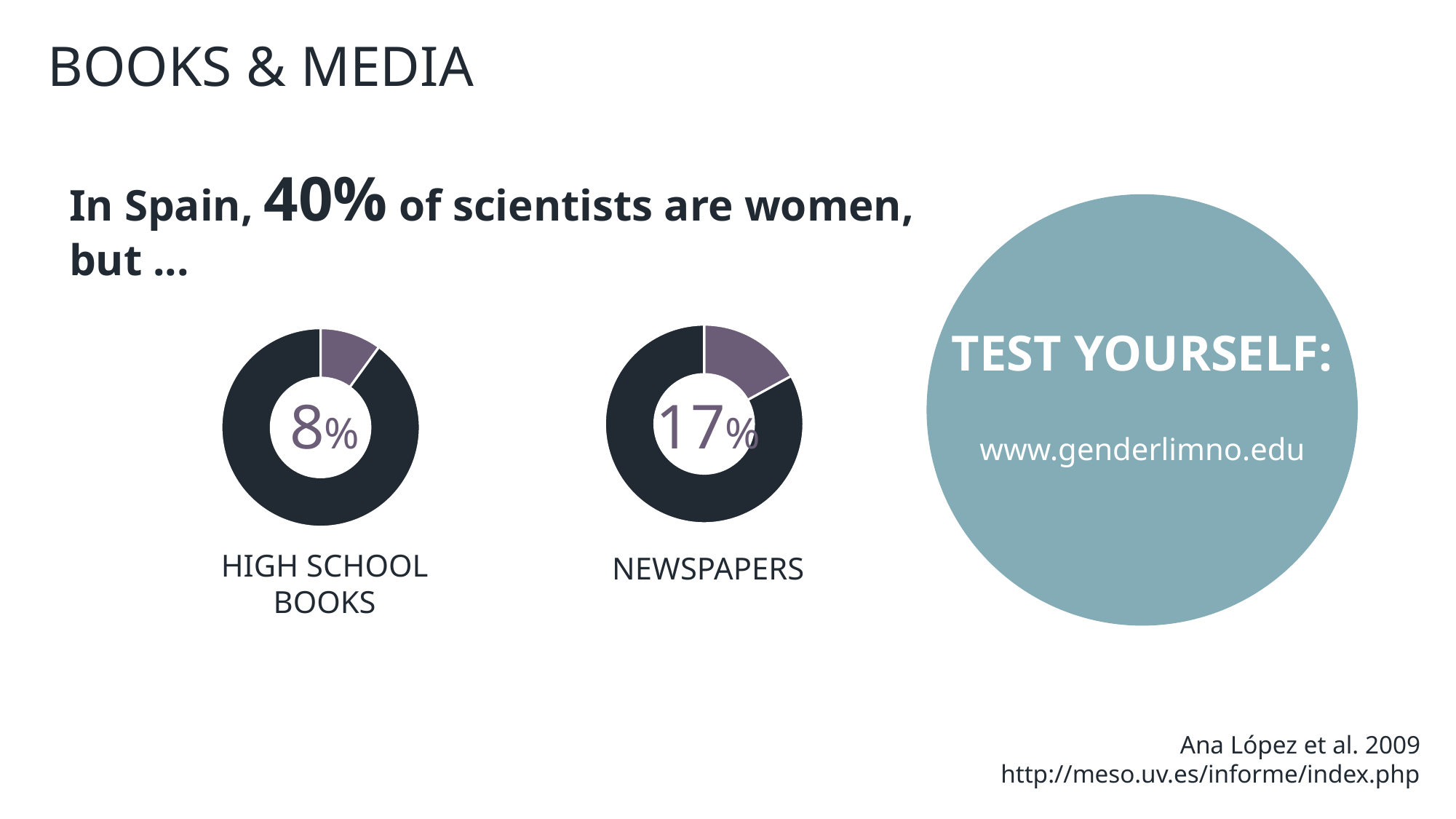
What kind of chart is used to show the High School Books and Newspapers values? Doughnut chart Which of the two charts shows the highest value? Newspapers What percentage is shown in the Newspapers chart? 17% Which of the two charts shows the lowest value? High School Books What is the label under the left doughnut chart? High School Books In the Newspapers chart, what share of the ring is not covered by the highlighted 17% slice? 83% What is the difference between the Newspapers percentage and the High School Books percentage? 9 percentage points What colour is the highlighted slice in each doughnut chart? Purple Which chart shows the larger percentage, High School Books or Newspapers? Newspapers How many doughnut charts are on the slide? 2 What percentage is shown in the High School Books chart? 8%